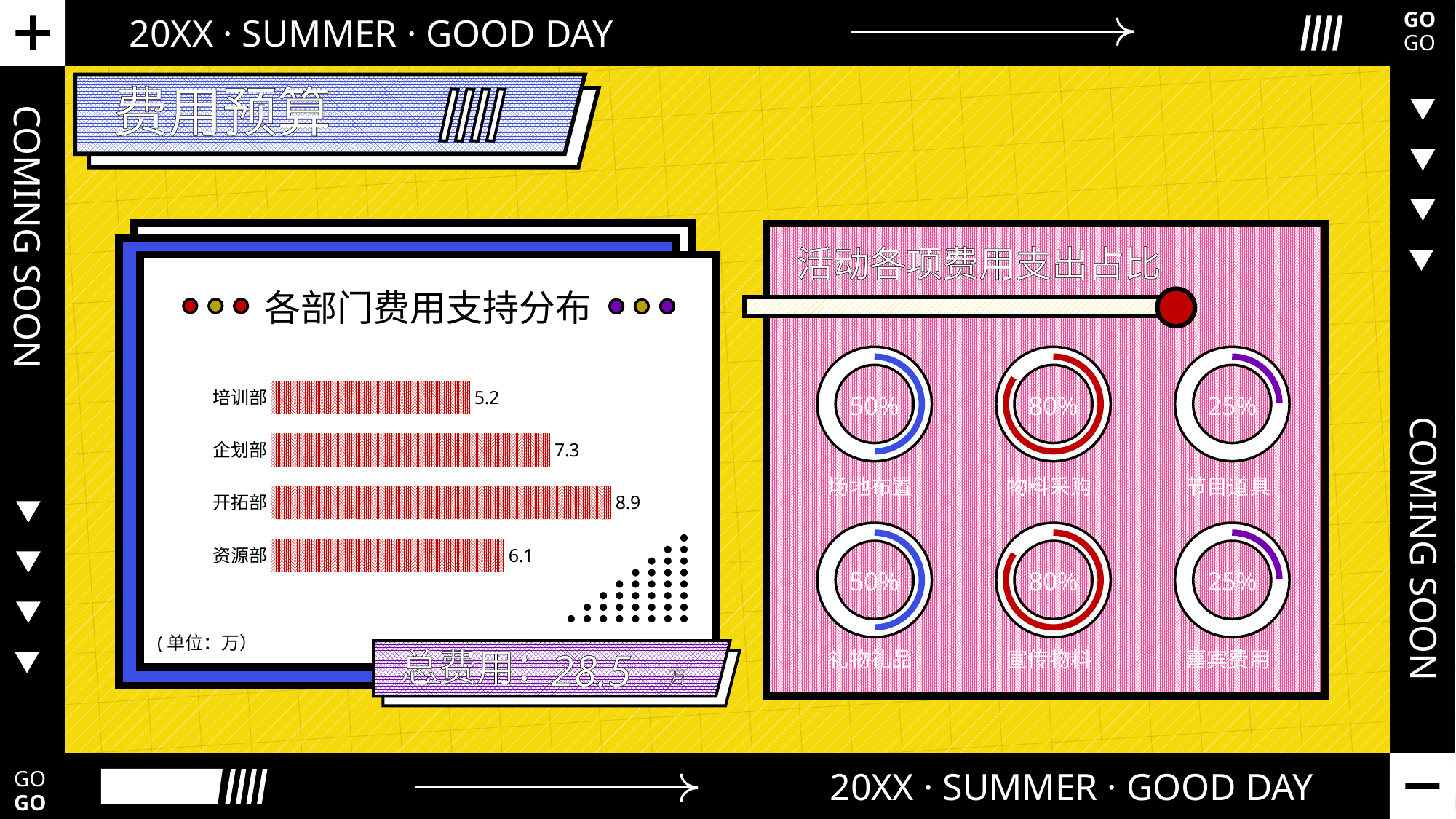
In the chart titled 各部门费用支持分布, what is the difference between the values for 开拓部 and 培训部? 3.7 In the chart titled 各部门费用支持分布, which is larger, the value for 企划部 or the value for 资源部? 企划部 In the chart titled 各部门费用支持分布, what is the value for 培训部? 5.2 What kind of chart is 各部门费用支持分布? bar chart In the chart titled 各部门费用支持分布, which department has the lowest value? 培训部 What is the total of all four department values in the chart titled 各部门费用支持分布? 27.5 In the chart titled 各部门费用支持分布, which department has the highest value? 开拓部 In the chart titled 各部门费用支持分布, what is the value for 资源部? 6.1 What unit is stated for the values in the chart titled 各部门费用支持分布? 万 In the panel titled 活动各项费用支出占比 on the right, what percentage is shown for 物料采购? 80% In the chart titled 各部门费用支持分布, what is the value for 开拓部? 8.9 How many departments are shown in the chart titled 各部门费用支持分布? 4